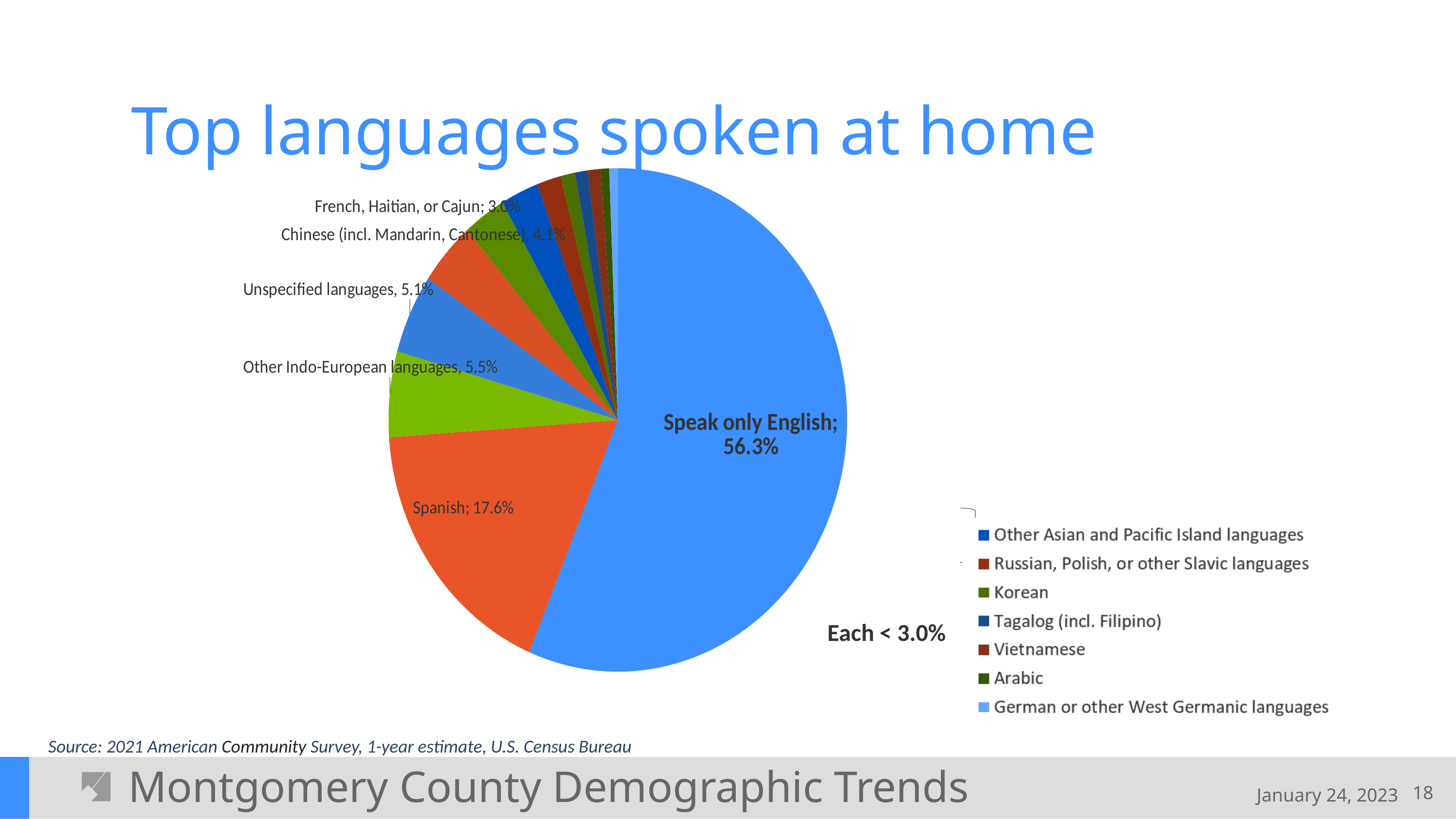
What share of the pie is labeled for Speak only English? 56.3% What share is labeled for French, Haitian, or Cajun? 3.0% What share is labeled for Chinese (incl. Mandarin, Cantonese)? 4.1% What share of the pie is labeled for Spanish? 17.6% What kind of chart is shown on the slide? pie chart What is the difference in percentage points between Speak only English and Spanish? 38.7 Which category has the largest slice of the pie? Speak only English What share is labeled for Unspecified languages? 5.1% What is the title of the chart? Top languages spoken at home What share is labeled for Other Indo-European languages? 5.5% Which is larger, the share for Unspecified languages or the share for Chinese (incl. Mandarin, Cantonese)? Unspecified languages How many language categories are listed in the legend as each being less than 3.0%? 7